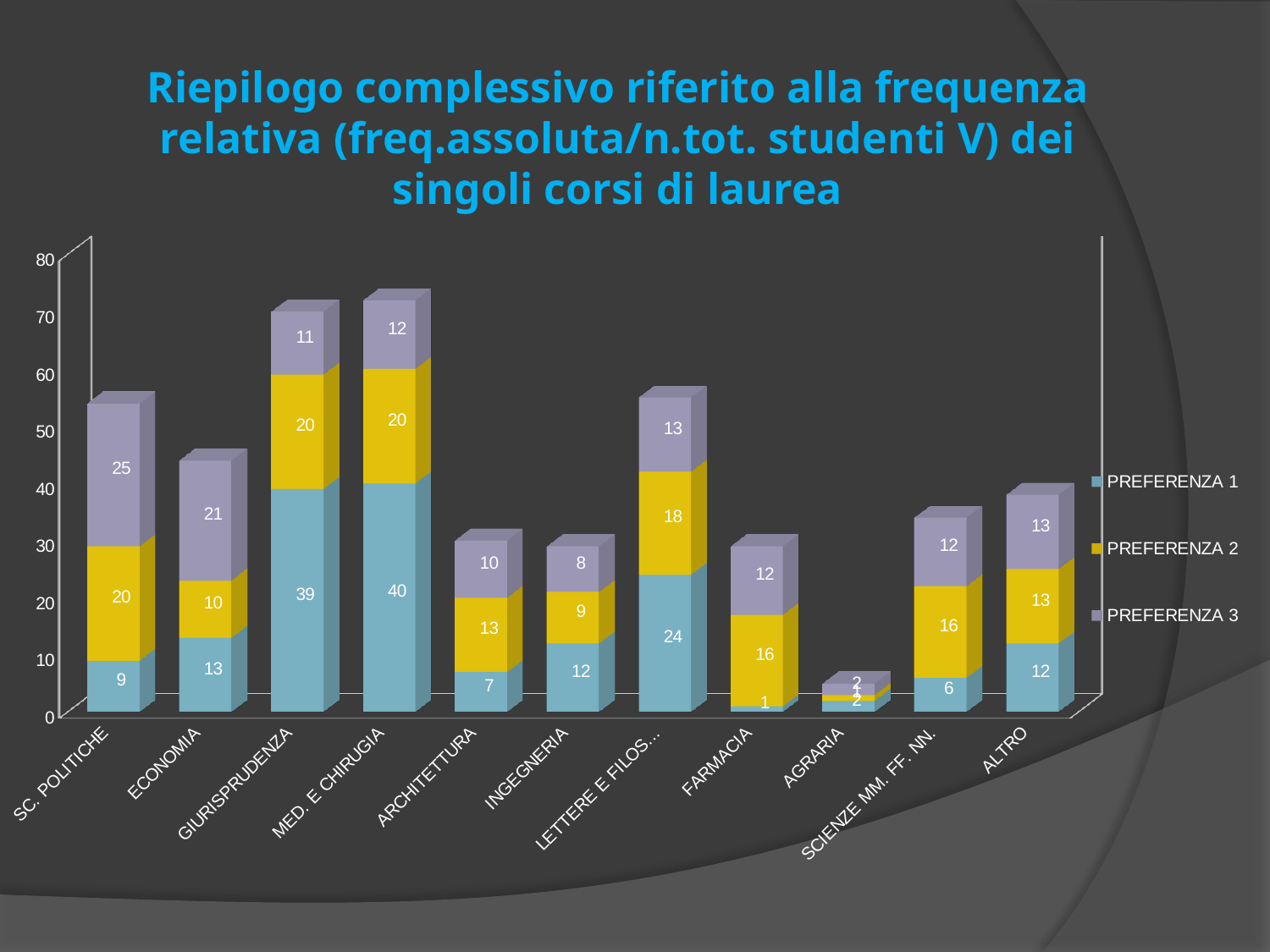
What is the PREFERENZA 2 value for FARMACIA? 16 What is the total of the stacked bar for LETTERE E FILOS...? 55 What is the PREFERENZA 1 value for GIURISPRUDENZA? 39 What is the difference between the PREFERENZA 1 values for MED. E CHIRUGIA and GIURISPRUDENZA? 1 Which category has the highest PREFERENZA 1 value? MED. E CHIRUGIA What kind of chart is shown on the slide? Stacked bar chart How many categories are shown on the x axis? 11 How many series does the legend list? 3 What is the PREFERENZA 3 value for SC. POLITICHE? 25 Which is larger, the PREFERENZA 2 value for ARCHITETTURA or for INGEGNERIA? ARCHITETTURA Which category has the highest PREFERENZA 3 value? SC. POLITICHE What is the total of the stacked bar for ECONOMIA? 44